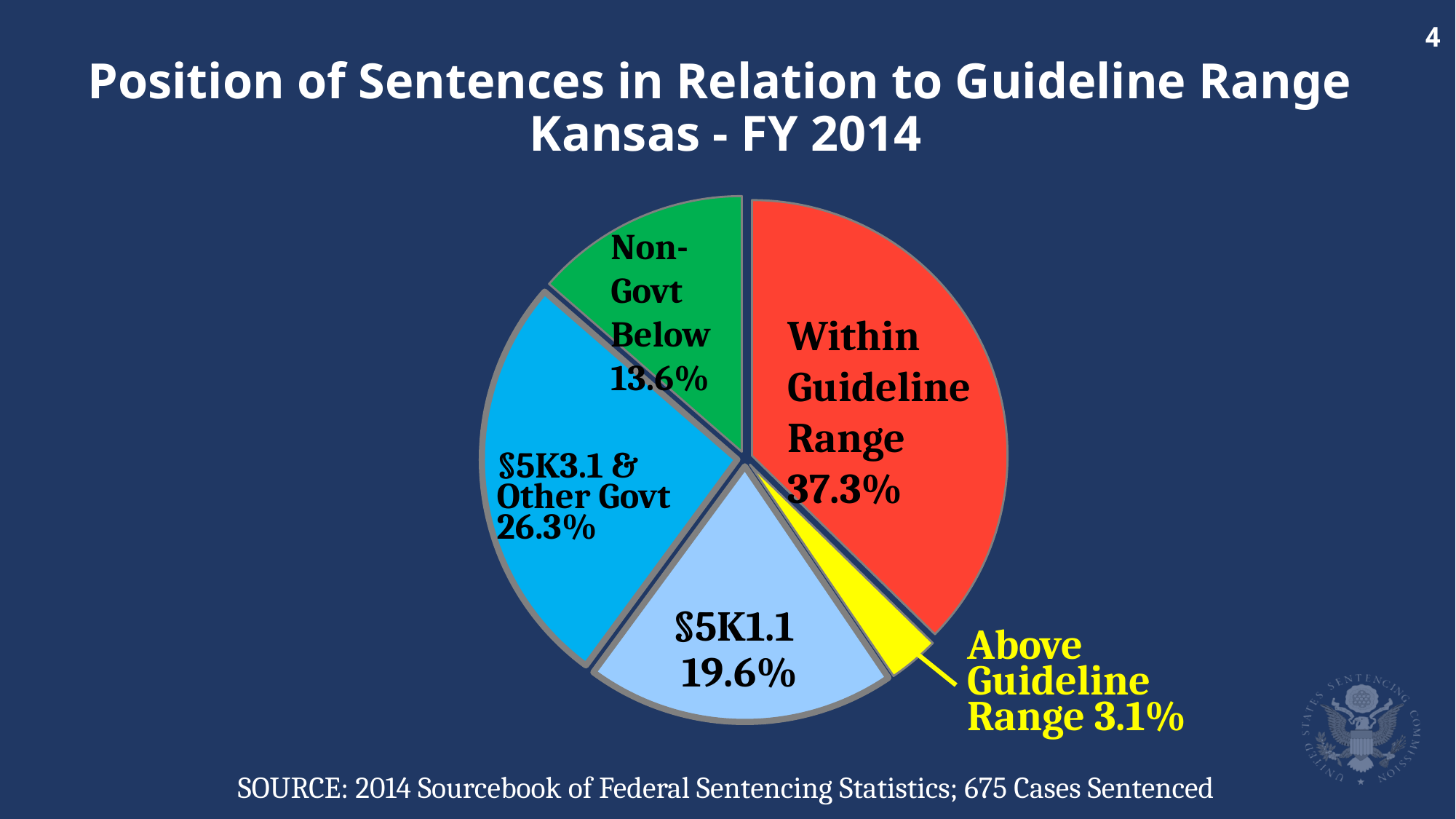
What percentage is shown for §5K3.1 & Other Govt? 26.3% What share of sentences were Non-Govt Below? 13.6% What share of sentences were Within Guideline Range? 37.3% What is the difference in percentage points between Within Guideline Range and §5K1.1? 17.7 Which is larger, §5K3.1 & Other Govt or Non-Govt Below? §5K3.1 & Other Govt Which category has the largest share of the pie? Within Guideline Range How many slices does the pie chart have? 5 What percentage is shown for the §5K1.1 slice? 19.6% Which category has the smallest share of the pie? Above Guideline Range What colour is the Above Guideline Range slice? Yellow What percentage of sentences were Above Guideline Range? 3.1% What type of chart is shown on the slide? Pie chart